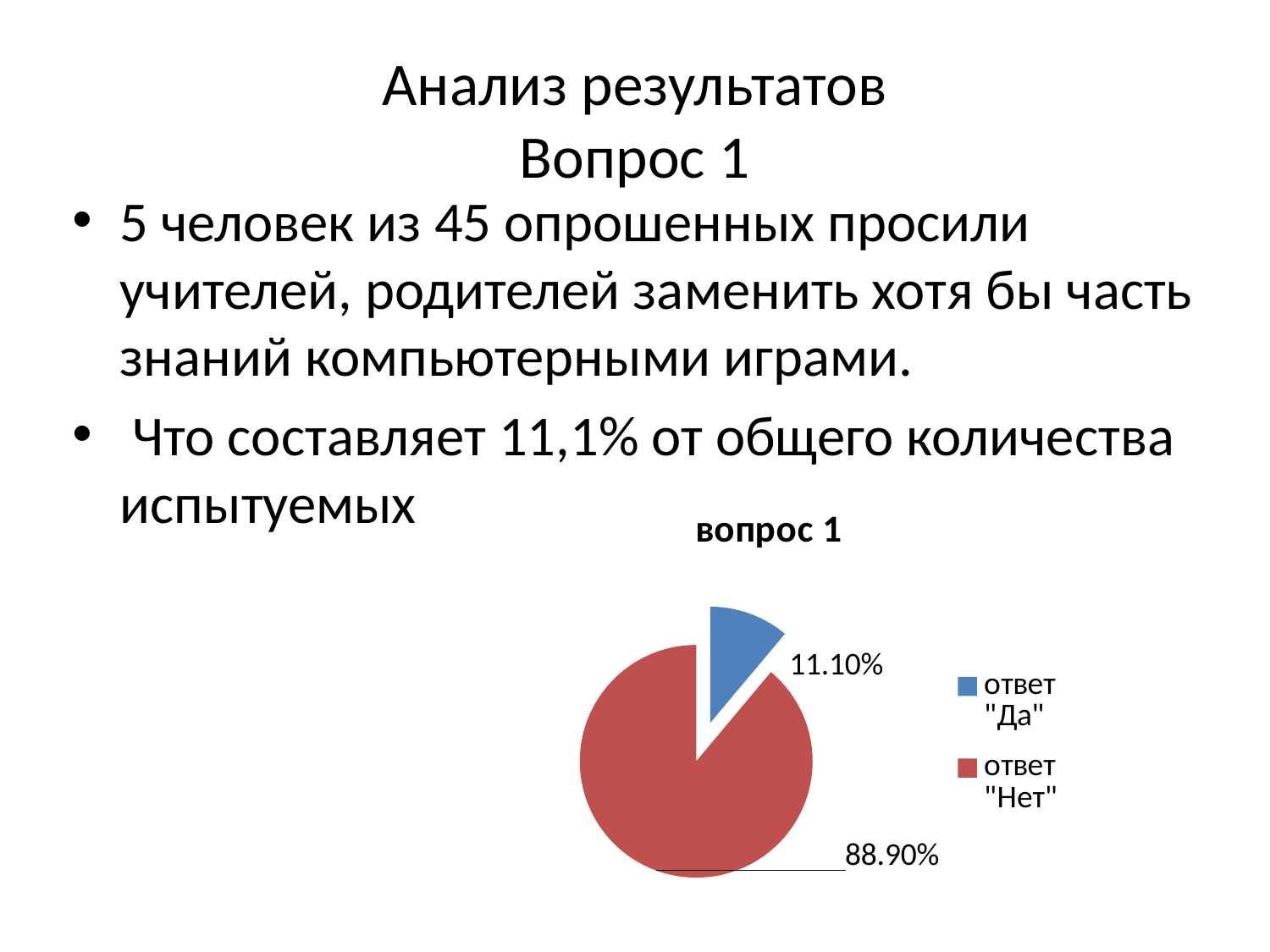
How many entries does the legend list? 2 What is the title of the chart? вопрос 1 What colour is the slice for ответ "Да"? blue What is the difference between the shares for ответ "Нет" and ответ "Да"? 77.80% What share of the pie is labelled for ответ "Нет"? 88.90% Which is larger, the share for ответ "Да" or the share for ответ "Нет"? ответ "Нет" Which slice of the pie is the smallest? ответ "Да" What share of the pie is labelled for ответ "Да"? 11.10% How many slices does the pie chart have? 2 What kind of chart is shown on the slide? pie chart Which slice of the pie is the largest? ответ "Нет"